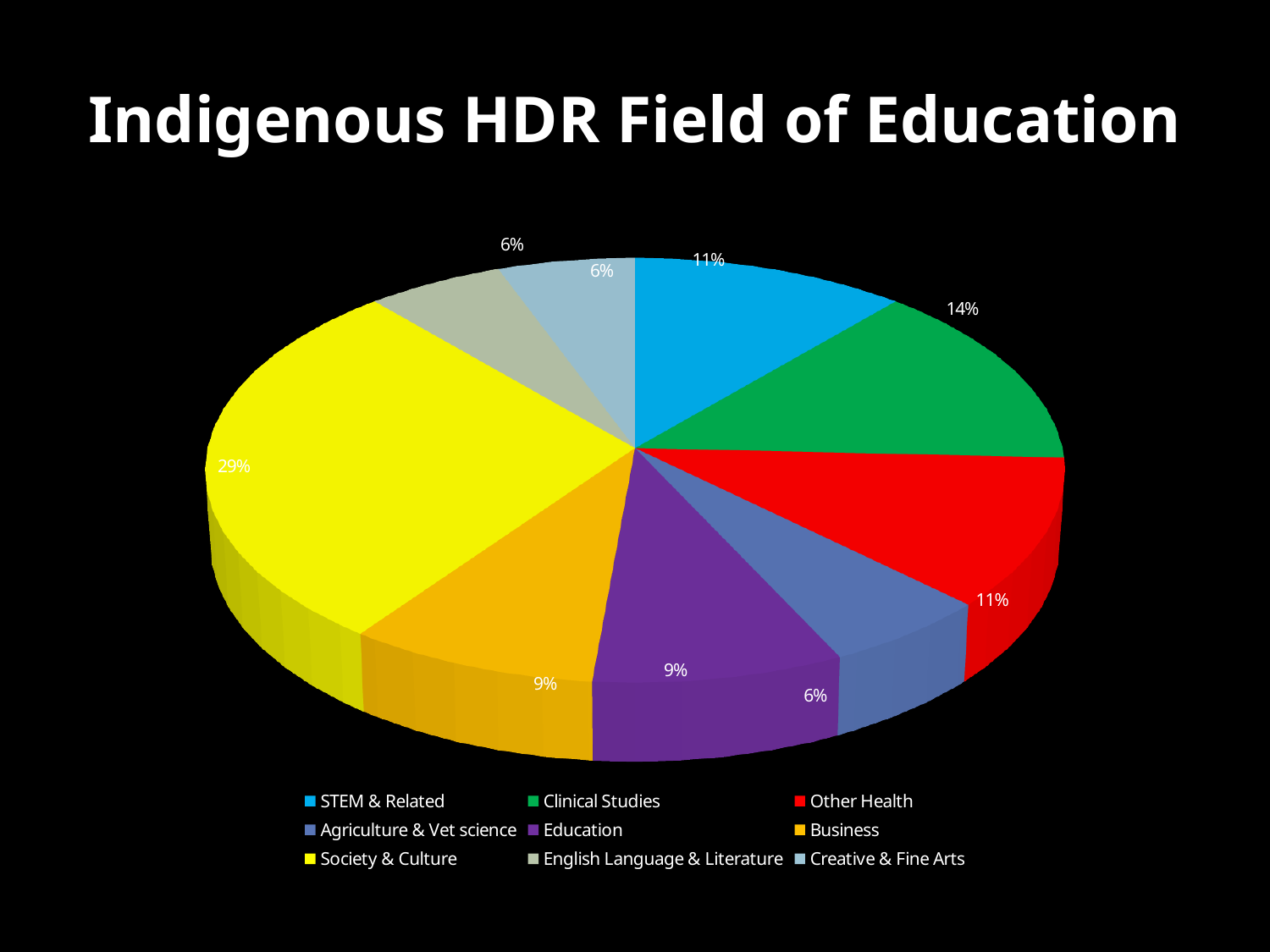
Which field of education has the largest share of the pie? Society & Culture What type of chart is shown on the slide? Pie chart What percentage is shown for Agriculture & Vet science? 6% What is the title of the chart? Indigenous HDR Field of Education What percentage is shown for STEM & Related? 11% Which is larger, the share for Clinical Studies or the share for Other Health? Clinical Studies What is the difference in percentage points between Society & Culture and Clinical Studies? 15 What percentage is shown for Education? 9% What percentage is shown for Clinical Studies? 14% How many categories are shown in the pie chart? 9 What share of the pie does Society & Culture represent? 29% What colour is the Business slice in the pie chart? Orange